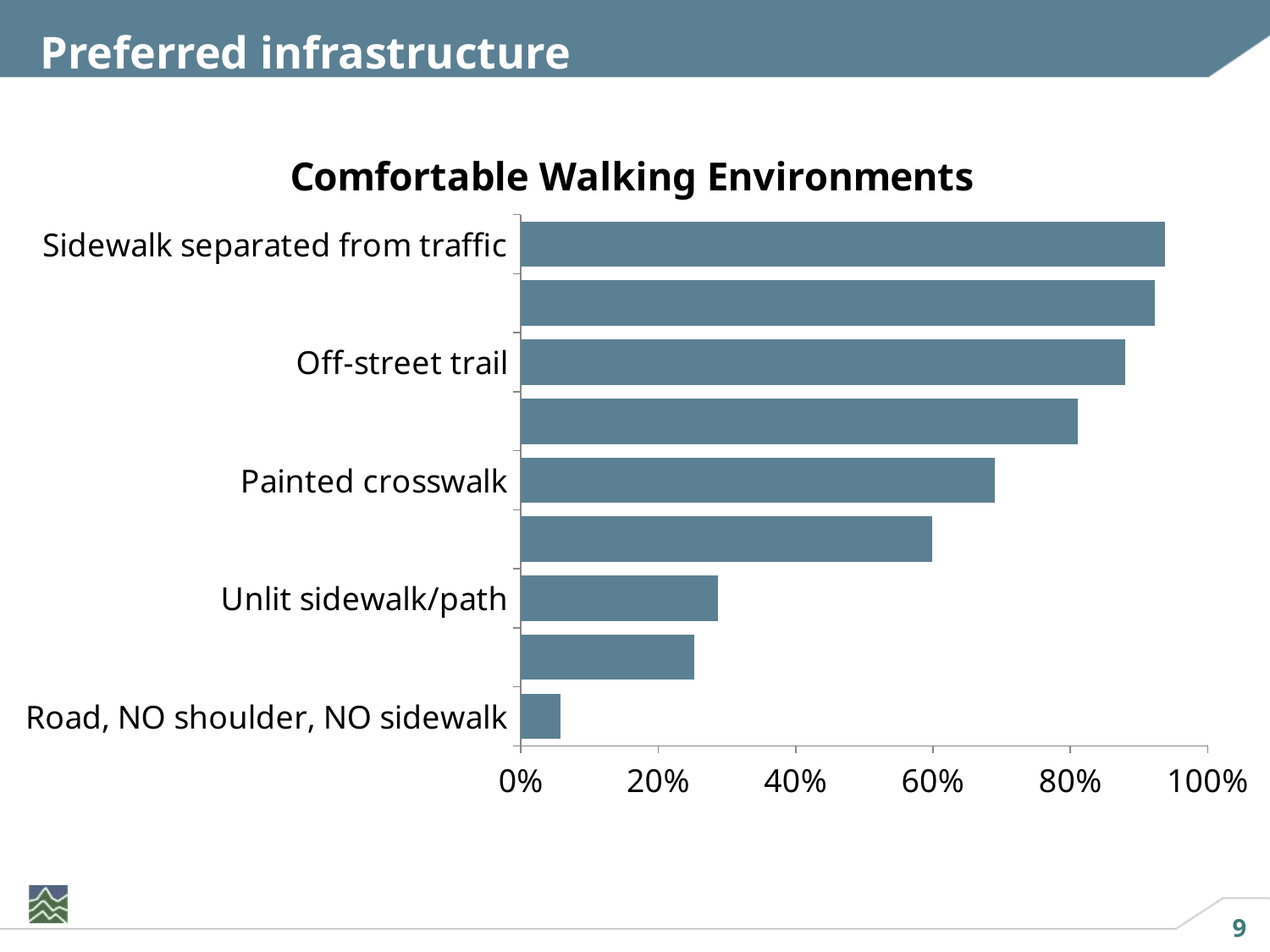
What is the title of the chart? Comfortable Walking Environments Is the value for Road, NO shoulder, NO sidewalk greater or less than 20%? less Is the value for Painted crosswalk greater or less than 60%? greater Which is larger, the value for Unlit sidewalk/path or the value for Road, NO shoulder, NO sidewalk? Unlit sidewalk/path Which labeled category has the shortest bar? Road, NO shoulder, NO sidewalk Which labeled category has the longest bar? Sidewalk separated from traffic How many bars are plotted in the chart? 9 Do the bar values increase or decrease going from the top of the chart to the bottom? decrease What kind of chart is shown on the slide? Bar chart Is the value for Sidewalk separated from traffic greater or less than 80%? greater Which is larger, the value for Off-street trail or the value for Painted crosswalk? Off-street trail